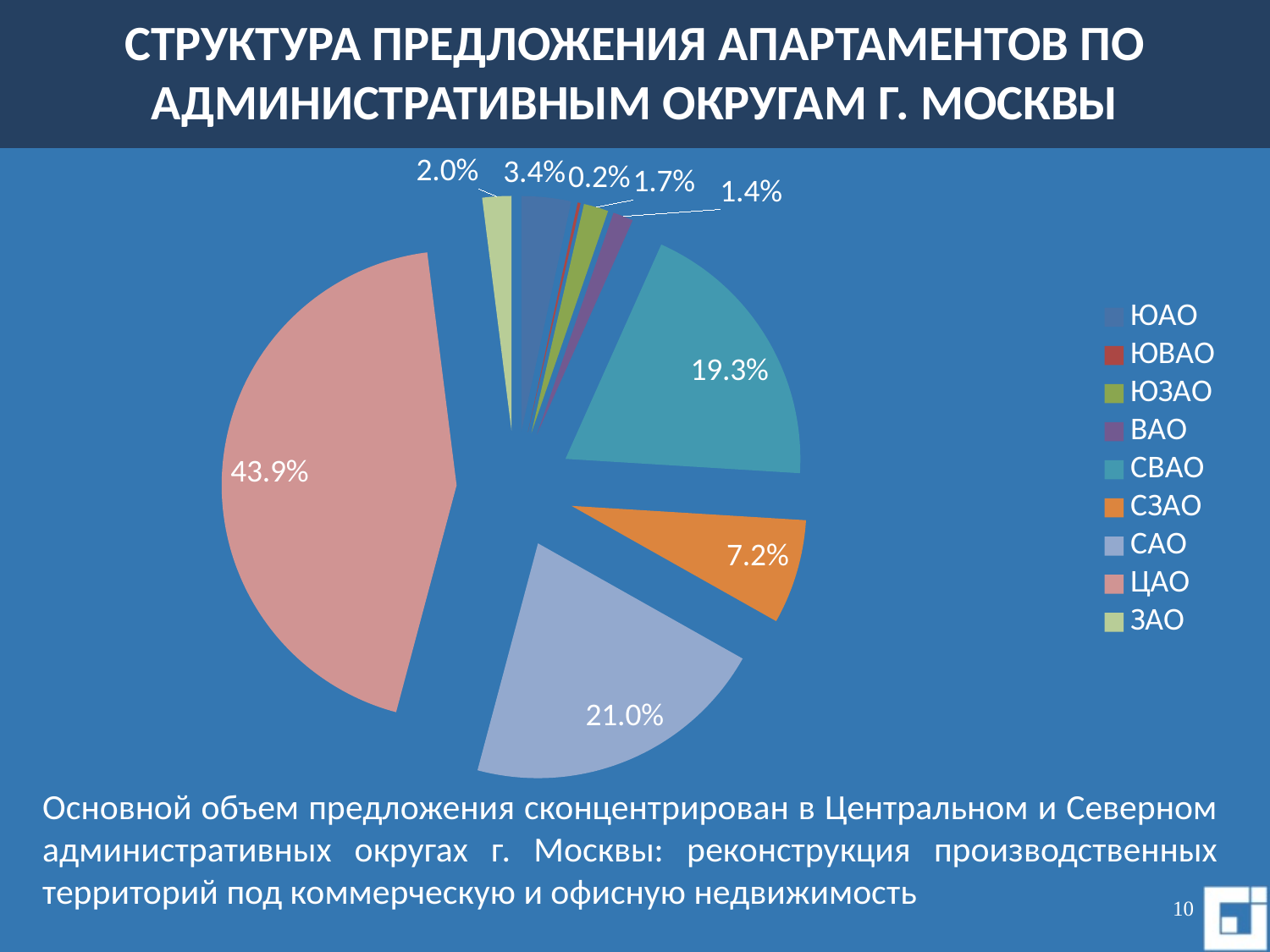
Which district has the largest share of the pie? ЦАО What is the difference in percentage points between ЦАО and САО? 22.9 What kind of chart is shown on the slide? pie chart Which is larger, the share for САО or the share for СВАО? САО How many districts (slices) are shown in the pie chart? 9 What share of the pie does ЦАО have? 43.9% What is the value shown for ЗАО? 2.0% What is the value shown for САО? 21.0% Which district has the smallest share of the pie? ЮВАО How many entries does the legend list? 9 What is the value shown for СЗАО? 7.2% What is the value shown for СВАО? 19.3%